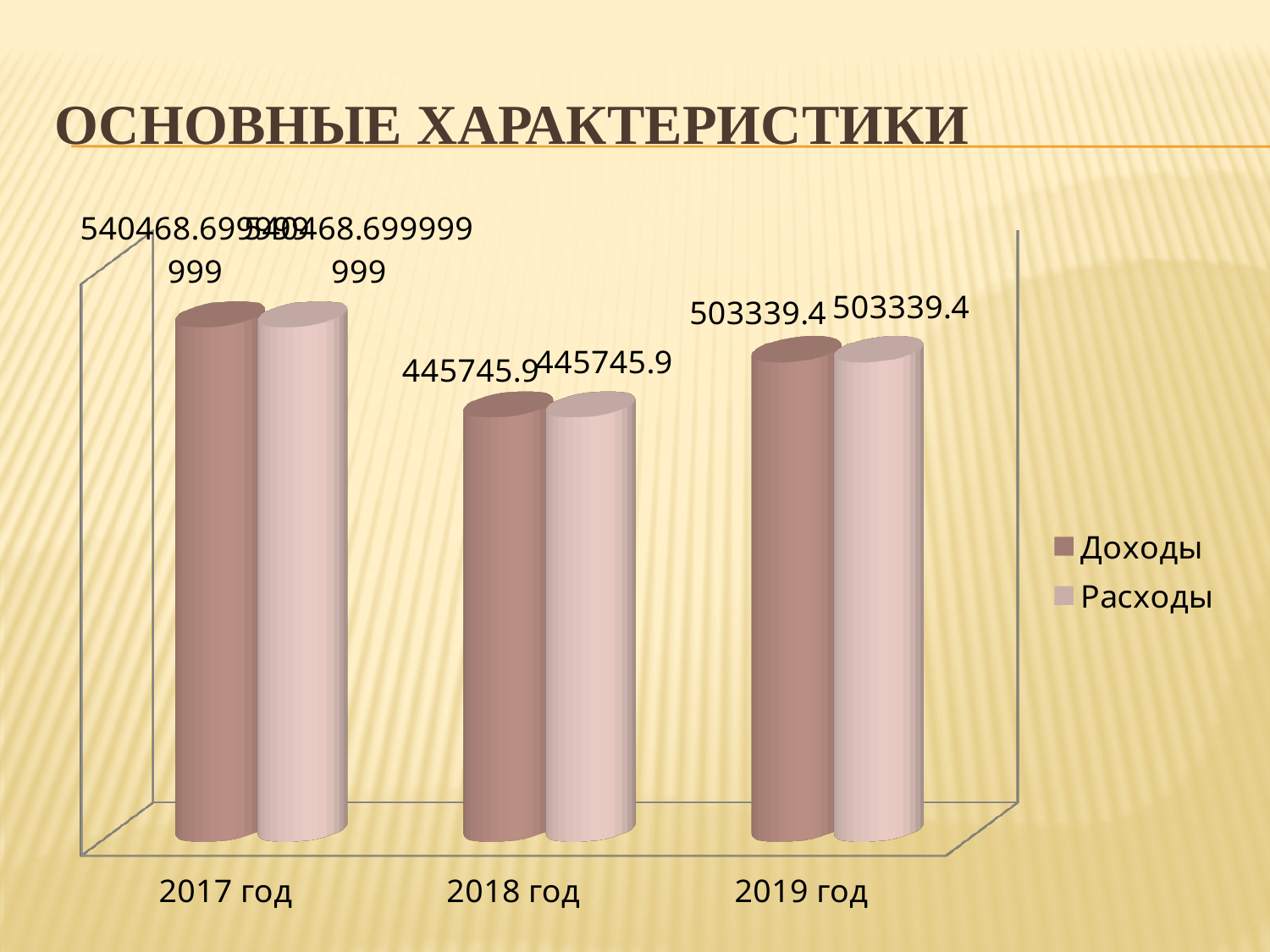
Which year has the lowest value for Расходы? 2018 год What is the value of Доходы for 2018 год? 445745.9 What type of chart is shown on the slide? bar chart What is the title of the slide containing the chart? ОСНОВНЫЕ ХАРАКТЕРИСТИКИ How many year categories are shown on the x axis? 3 What are the two series named in the legend? Доходы and Расходы Which is larger: Расходы for 2019 год or Расходы for 2018 год? 2019 год What is the value of Расходы for 2018 год? 445745.9 How many series does the legend list? 2 Which year has the highest value for Доходы? 2017 год What is the value of Расходы for 2019 год? 503339.4 What is the difference between Доходы for 2019 год and Доходы for 2018 год? 57593.5